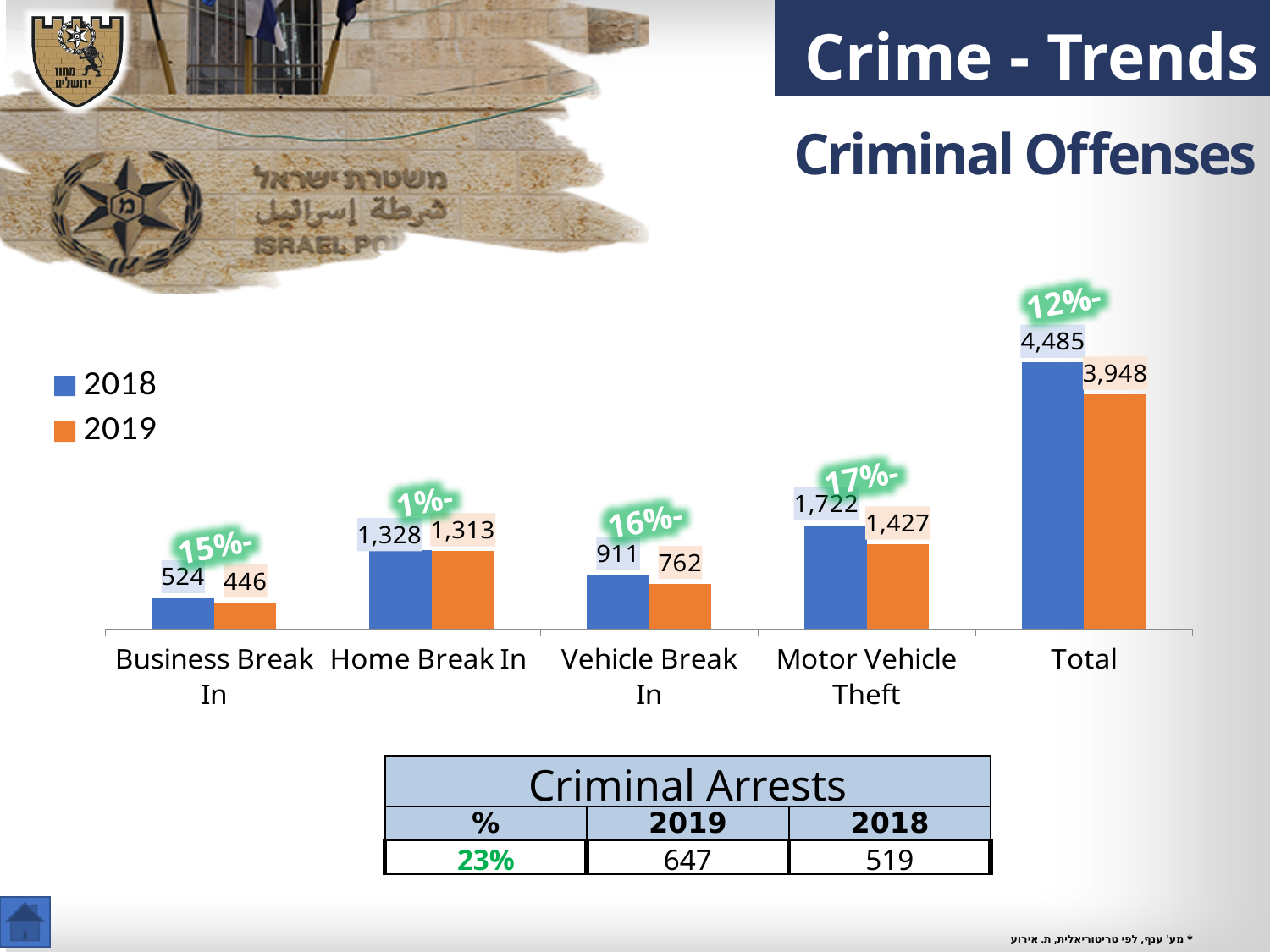
What is the 2018 value for Total? 4,485 What is the 2019 value for Motor Vehicle Theft? 1,427 How many categories are shown on the x axis of the chart? 5 Which category has the lowest 2019 value? Business Break In How many series does the chart legend list? 2 What is the 2018 value for Business Break In? 524 What is the difference between the 2018 and 2019 values for Total? 537 What is the difference between the 2018 and 2019 values for Vehicle Break In? 149 Which is larger, the 2018 value for Home Break In or the 2018 value for Vehicle Break In? Home Break In Excluding Total, which category has the highest 2018 value? Motor Vehicle Theft What is the 2019 value for Vehicle Break In? 762 What type of chart is shown on the slide? Bar chart